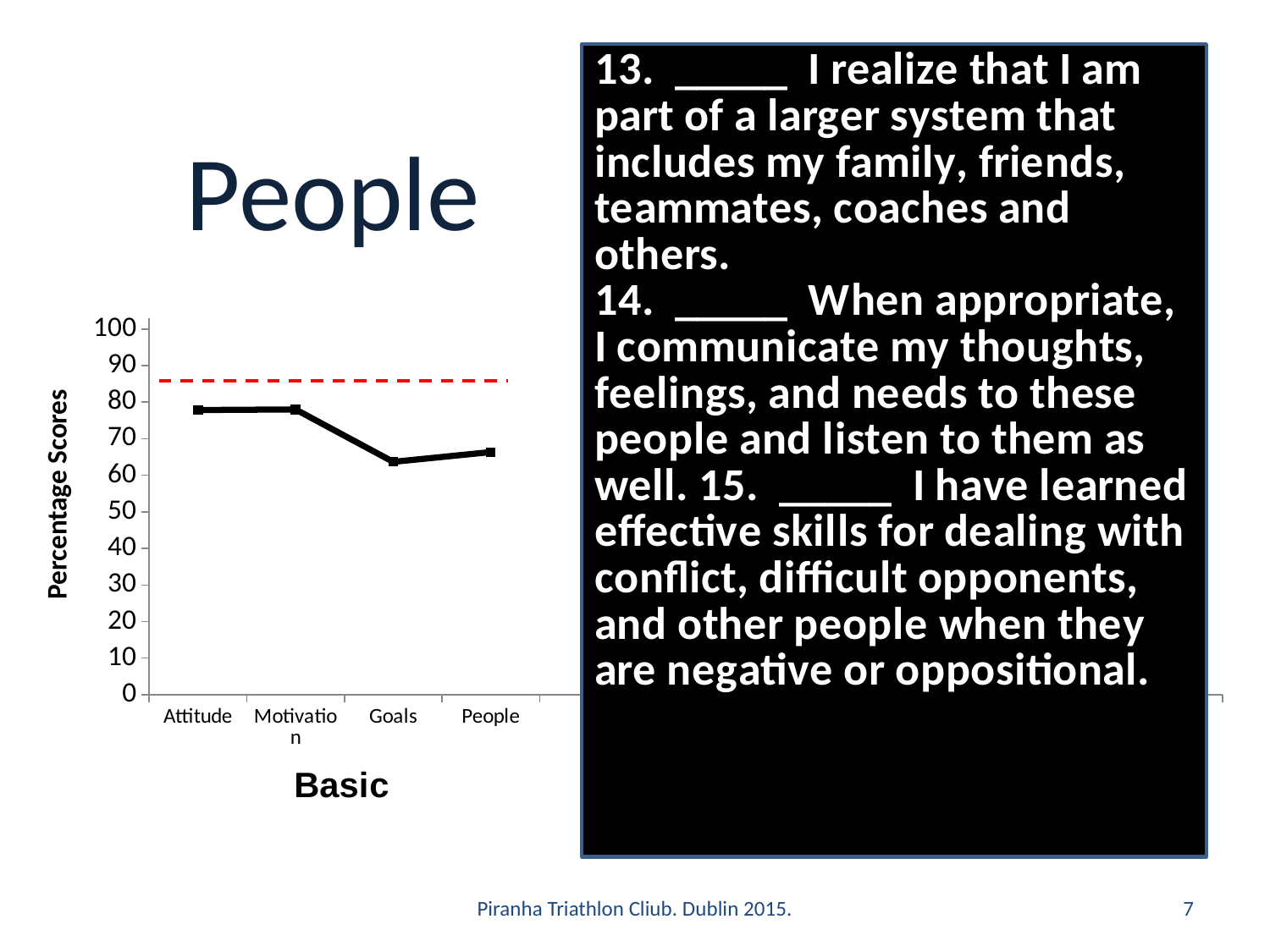
Is the value for Goals greater or less than 60? greater Does the line rise or fall from Motivation to Goals? fall Is the value for Goals greater or less than 70? less What kind of chart is shown on the slide? line chart Is the value for Motivation greater or less than 90? less Which has the larger value, Attitude or Goals? Attitude Does the line rise or fall from Goals to People? rise What is the title shown below the horizontal axis of the chart? Basic Which has the larger value, Motivation or People? Motivation What is the title of the vertical axis of the chart? Percentage Scores